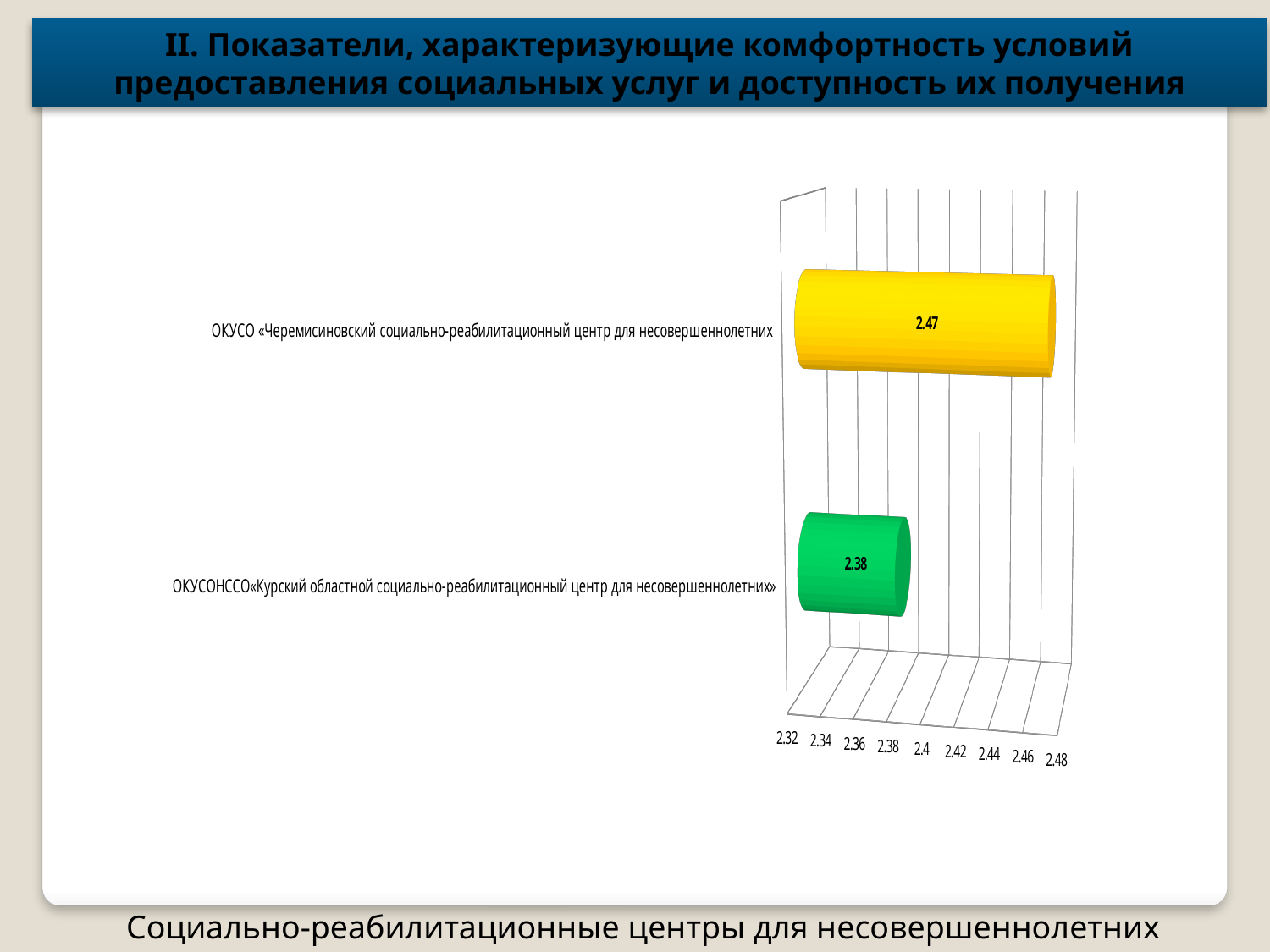
What colour is the bar for the Черемисиновский centre? Yellow Is the value for the Черемисиновский centre greater or less than 2.44? greater What is the value for ОКУСОНССО «Курский областной социально-реабилитационный центр для несовершеннолетних»? 2.38 Which category has the lowest value? ОКУСОНССО «Курский областной социально-реабилитационный центр для несовершеннолетних» Is the value for the Курский областной centre greater or less than 2.4? less Which category has the highest value? ОКУСО «Черемисиновский социально-реабилитационный центр для несовершеннолетних» What is the highest tick value shown on the value axis? 2.48 What is the difference between the values for the Черемисиновский centre and the Курский областной centre? 0.09 What kind of chart is shown on the slide? Bar chart What is the value for ОКУСО «Черемисиновский социально-реабилитационный центр для несовершеннолетних»? 2.47 How many categories are shown in the chart? 2 Which has a larger value, the Черемисиновский centre or the Курский областной centre? Черемисиновский centre